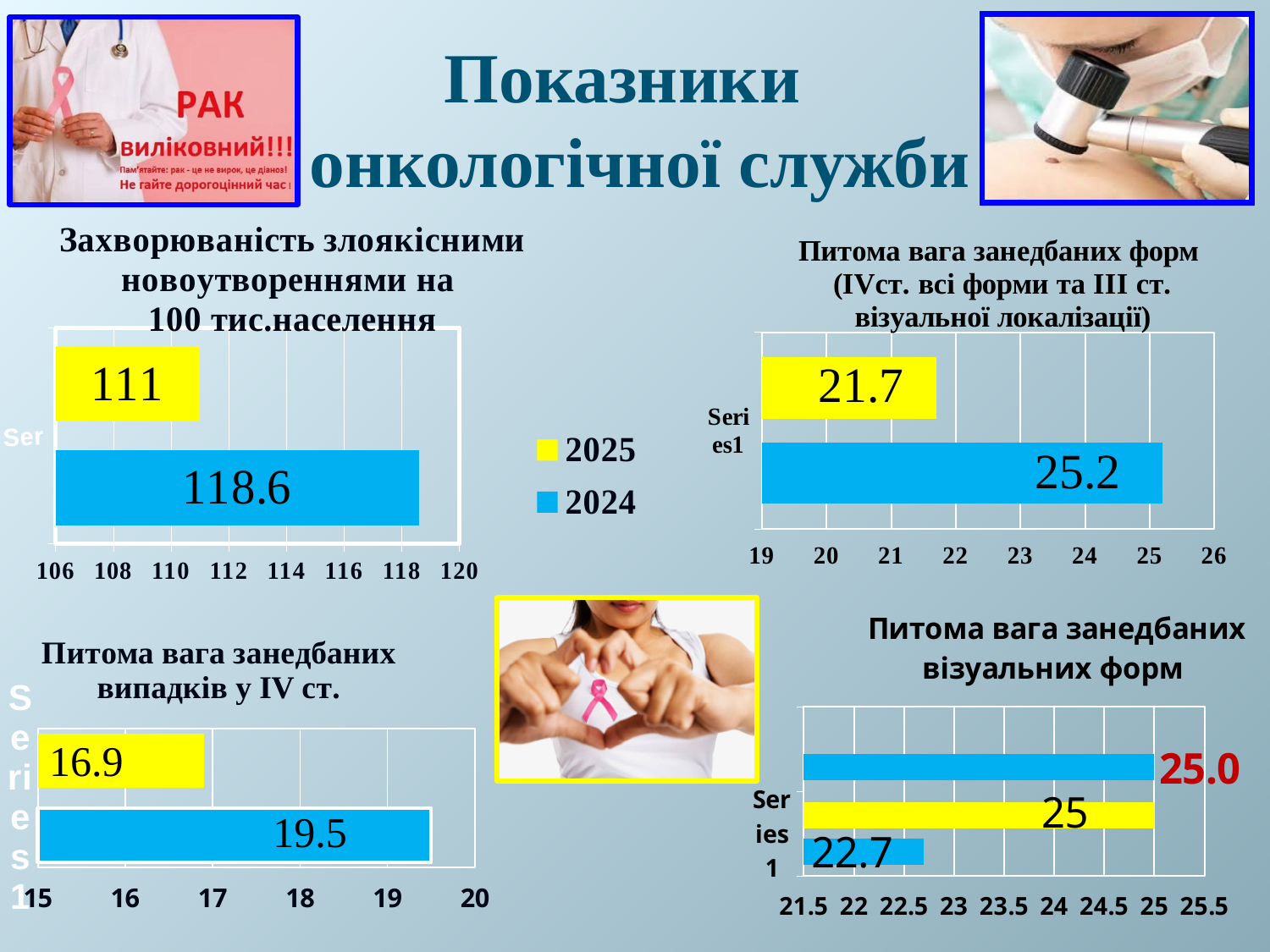
In the chart titled "Питома вага занедбаних візуальних форм", what is the lowest value shown? 22.7 In the chart titled "Питома вага занедбаних форм (IVст. всі форми та III ст. візуальної локалізації)", which bar is larger, the yellow or the blue one? the blue one (25.2) In the chart titled "Питома вага занедбаних візуальних форм", how many bars are plotted? 3 What kind of chart is the chart titled "Захворюваність злоякісними новоутвореннями на 100 тис.населення"? bar chart In the chart titled "Питома вага занедбаних форм (IVст. всі форми та III ст. візуальної локалізації)", what is the value of the yellow bar? 21.7 In the chart titled "Захворюваність злоякісними новоутвореннями на 100 тис.населення", what is the value of the yellow bar? 111 In the chart titled "Питома вага занедбаних форм (IVст. всі форми та III ст. візуальної локалізації)", what is the difference between the blue bar and the yellow bar? 3.5 In the chart titled "Питома вага занедбаних випадків у IV ст.", what is the difference between the blue bar and the yellow bar? 2.6 In the chart titled "Питома вага занедбаних випадків у IV ст.", what is the value of the blue bar? 19.5 In the chart titled "Захворюваність злоякісними новоутвореннями на 100 тис.населення", what is the value of the blue bar? 118.6 What two entries does the legend in the centre of the slide list? 2025 and 2024 In the chart titled "Захворюваність злоякісними новоутвореннями на 100 тис.населення", what is the difference between the blue bar and the yellow bar? 7.6